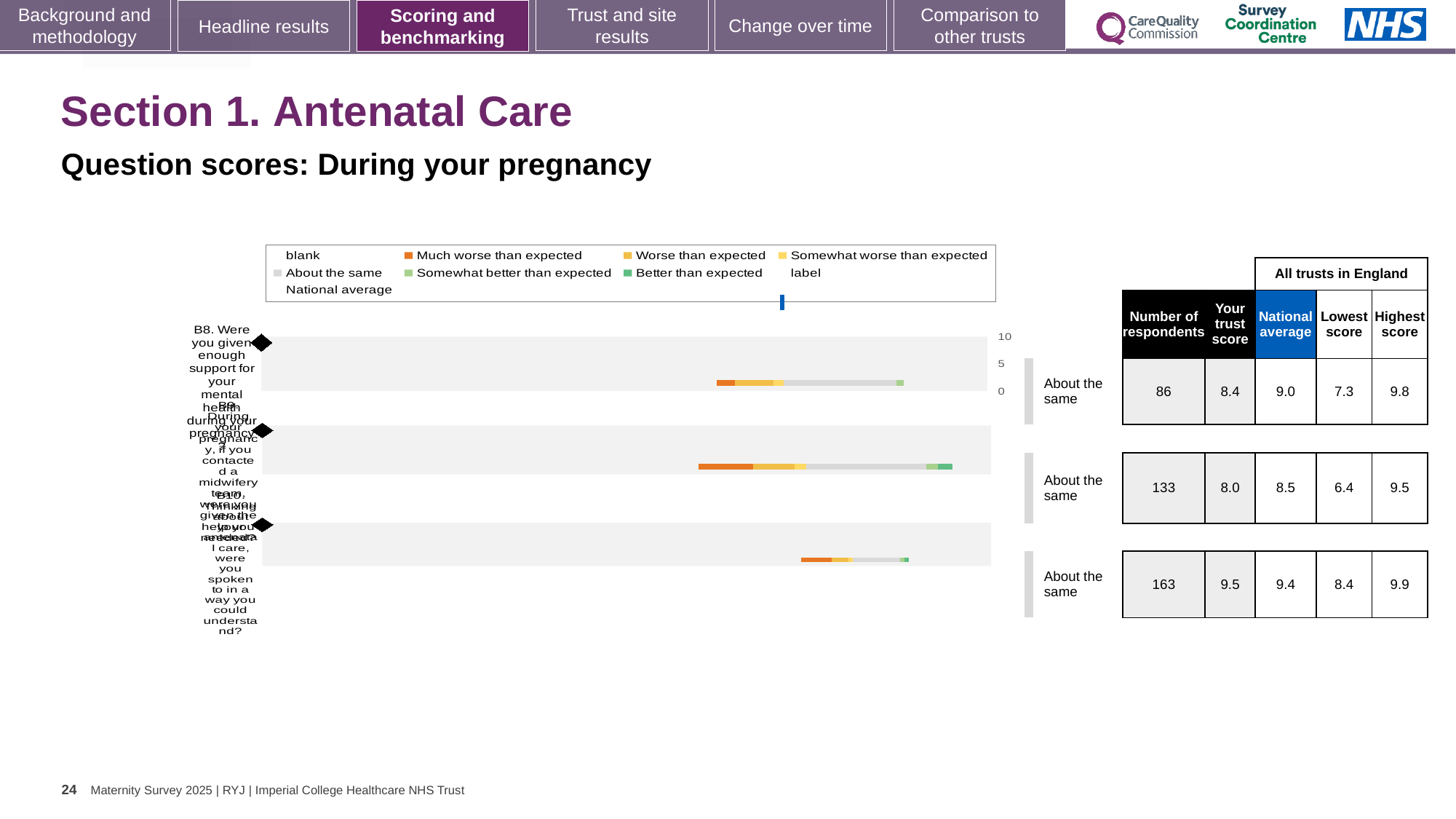
For the first question row (B8), which is larger: the trust score or the national average? the national average (9.0) What benchmark category is shown next to each of the three question rows? About the same What is the lowest score among all trusts in England for the third question row? 8.4 What kind of chart is shown on the slide? bar chart What is the trust score for the third (bottom) question row? 9.5 How many question rows (bars) are plotted in the chart? 3 What is the highest score among all trusts in England for the second question row? 9.5 Which question row has the lowest number of respondents? the first (top) row, B8, with 86 Which question row has the highest trust score? the third (bottom) row, 9.5 What is the number of respondents for the first (top) question, B8 about support for your mental health during pregnancy? 86 What colour does the legend use for 'Much worse than expected'? orange For the second question row, what is the difference between the national average (8.5) and the trust score (8.0)? 0.5